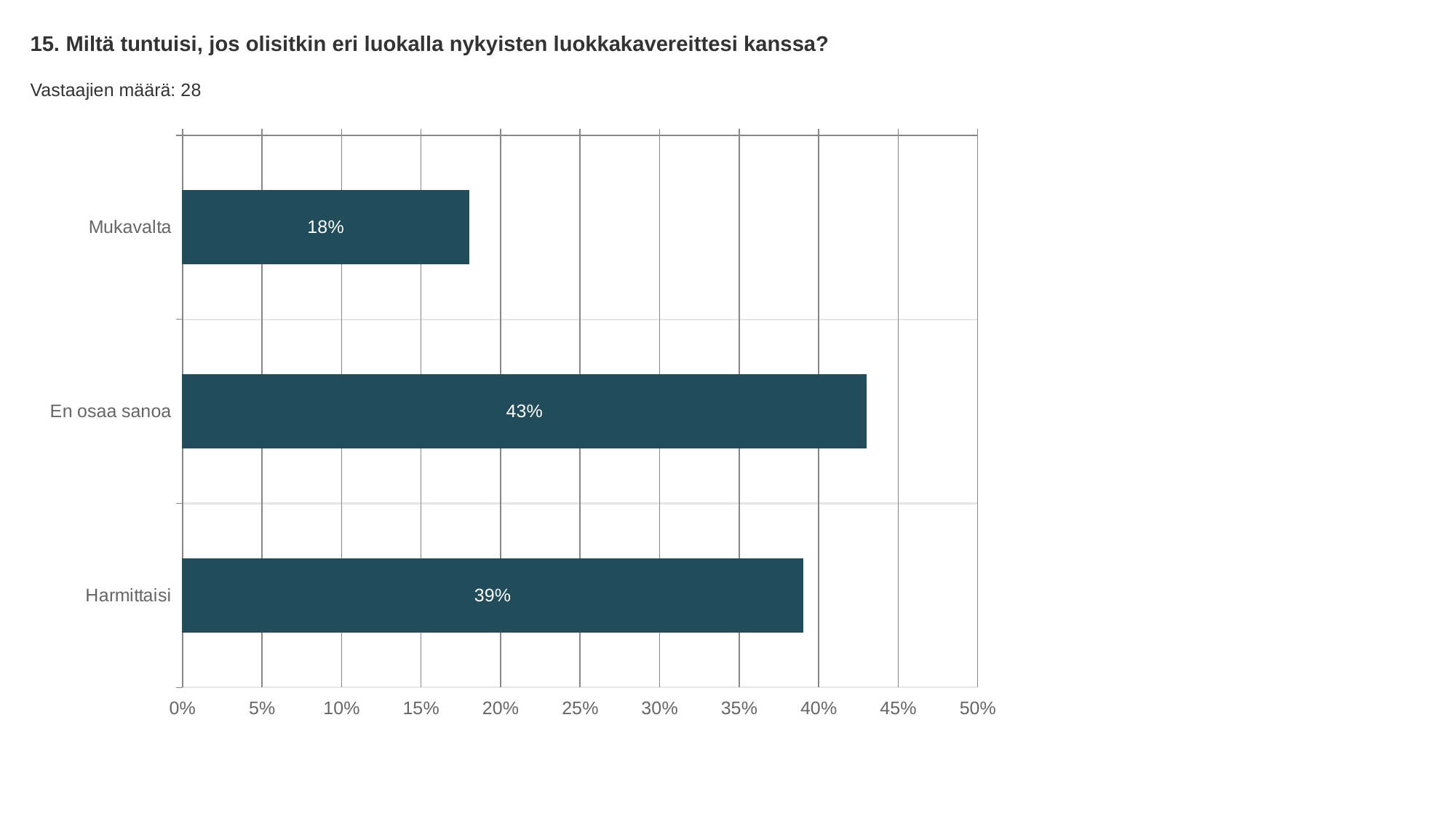
Which category has the highest value? En osaa sanoa What is the value for Harmittaisi? 39% What is the value for Mukavalta? 18% Which is larger, the value for Harmittaisi or the value for Mukavalta? Harmittaisi How many respondents (Vastaajien määrä) does the slide report? 28 What is the difference between the values for Harmittaisi and Mukavalta? 21% What is the value for En osaa sanoa? 43% Is the value for Harmittaisi greater or less than 40%? less What is the difference between the values for En osaa sanoa and Harmittaisi? 4% How many categories are shown in the chart? 3 What kind of chart is shown on the slide? bar chart Which category has the lowest value? Mukavalta